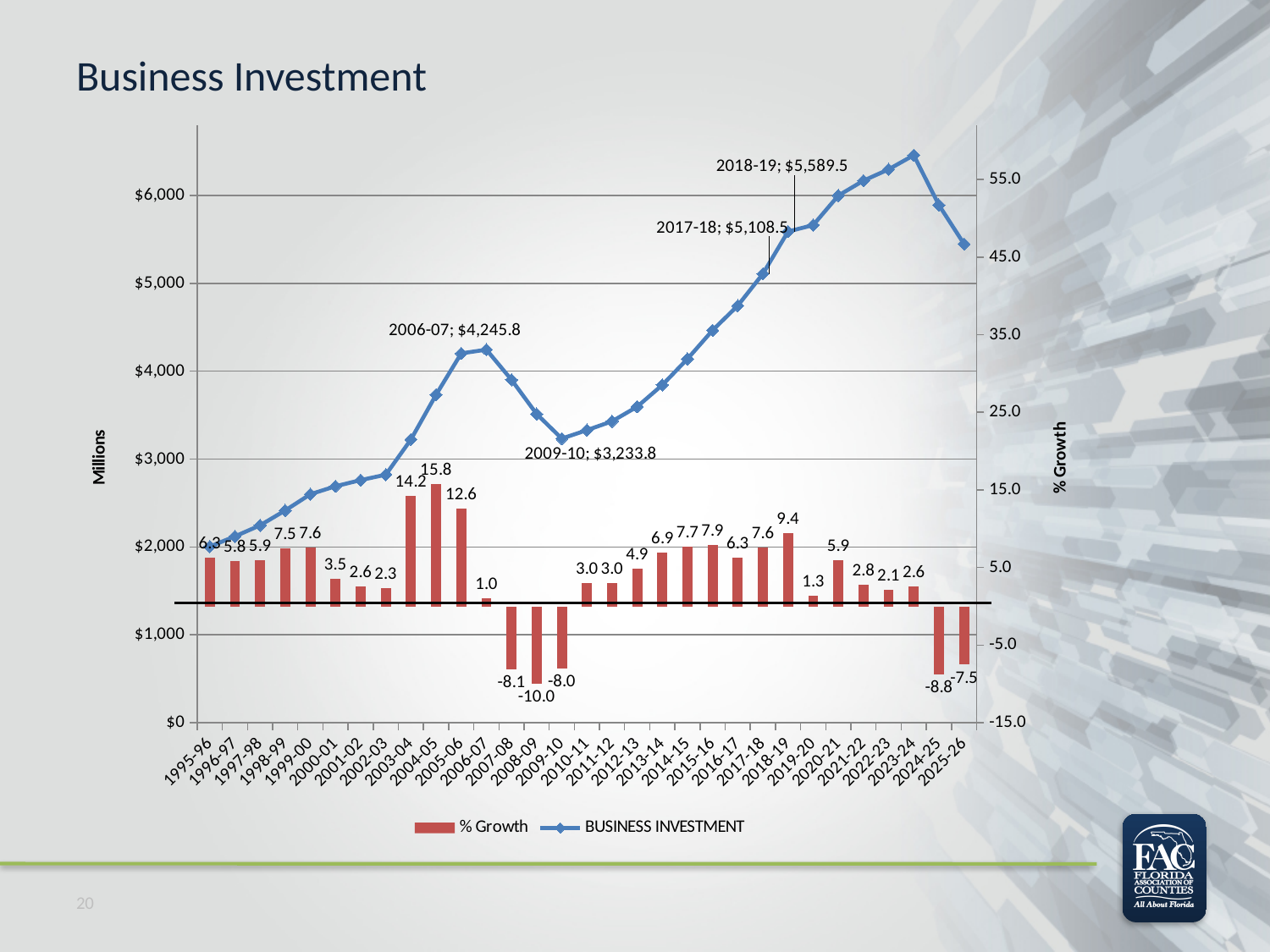
What is the % Growth value for 2004-05? 15.8 Which year has the lowest % Growth bar? 2008-09 Which year has the highest % Growth bar? 2004-05 What is the % Growth value for 2008-09? -10.0 What is the BUSINESS INVESTMENT value labelled for 2018-19? $5,589.5 What is the difference between the BUSINESS INVESTMENT values labelled for 2018-19 and 2017-18? $481.0 Is the BUSINESS INVESTMENT value for 2023-24 greater or less than $6,000? greater How many series does the legend list? 2 Does the BUSINESS INVESTMENT line rise or fall from 2009-10 to 2023-24? rise What type of chart is shown on the slide? Combined bar and line chart What is the BUSINESS INVESTMENT value labelled for 2009-10? $3,233.8 Which year has the larger % Growth, 2003-04 or 2005-06? 2003-04